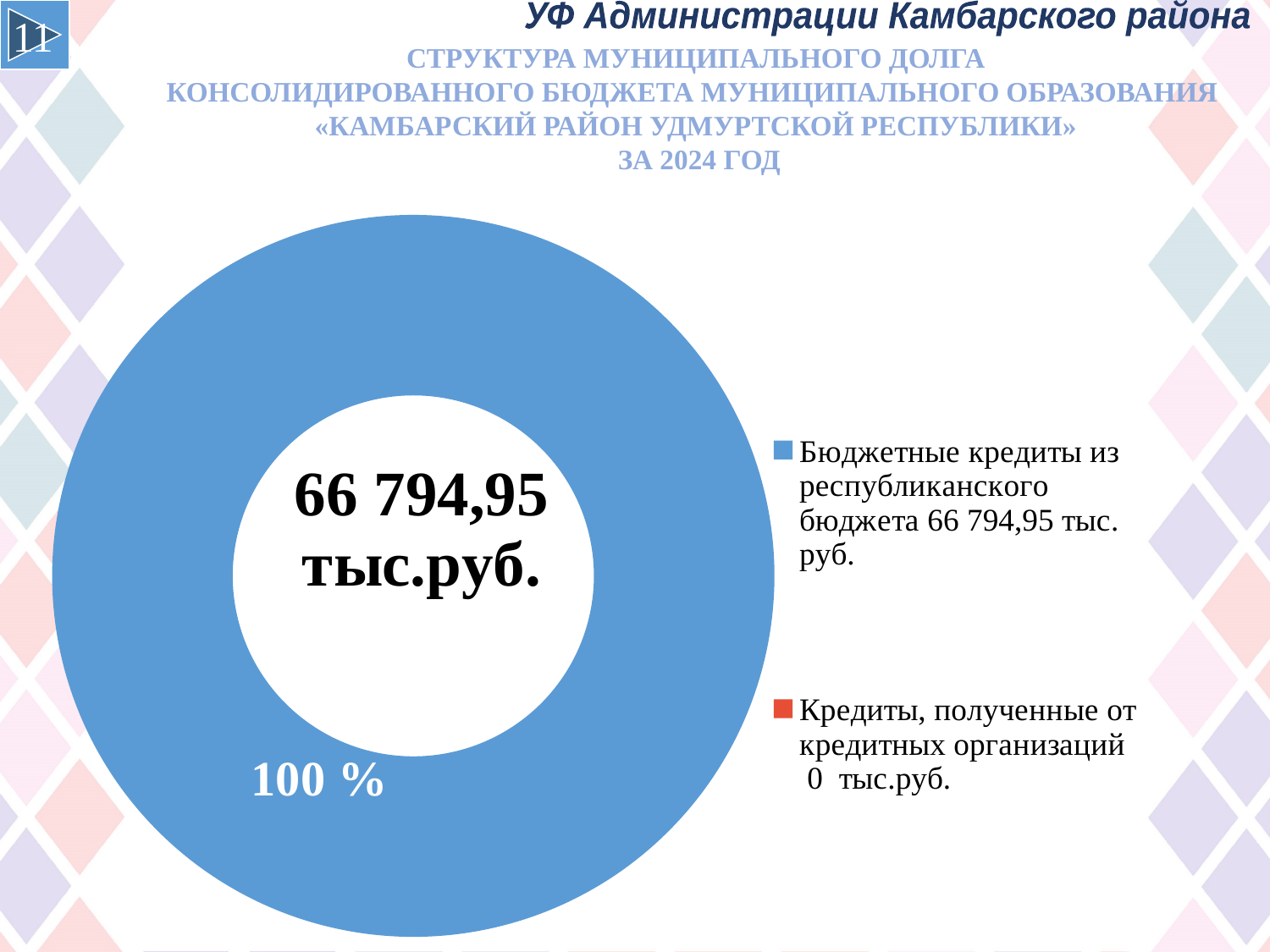
How many entries does the chart legend list? 2 What value is shown for «Бюджетные кредиты из республиканского бюджета»? 66 794,95 тыс. руб. What share of the chart does the blue slice (budget credits from the republican budget) represent? 100 % Which category is the largest in the chart? Бюджетные кредиты из республиканского бюджета Which is larger: budget credits from the republican budget or credits from credit organizations? Бюджетные кредиты из республиканского бюджета What colour is the slice for budget credits from the republican budget? blue Which category is the smallest in the chart? Кредиты, полученные от кредитных организаций What kind of chart is shown on the slide? doughnut (pie) chart What value is shown for «Кредиты, полученные от кредитных организаций»? 0 тыс.руб. What total value is printed in the centre of the doughnut chart? 66 794,95 тыс.руб. For which year does the chart show the structure of municipal debt? 2024 What is the difference between budget credits from the republican budget and credits from credit organizations? 66 794,95 тыс. руб.